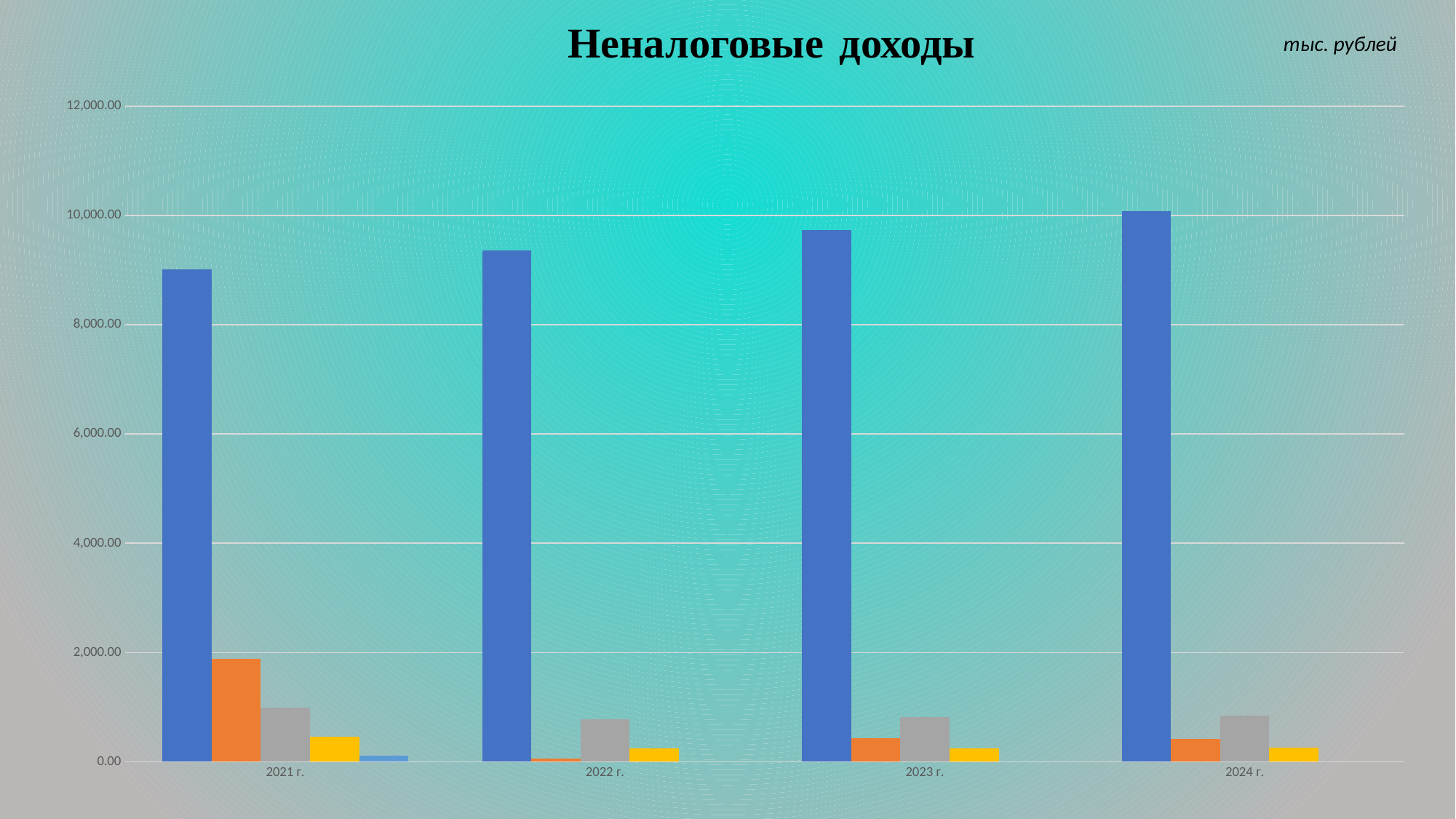
In which year is the dark blue bar the highest? 2024 г. What unit is indicated in the top right corner of the chart? тыс. рублей In which year is the dark blue bar the lowest? 2021 г. What is the title of the chart? Неналоговые доходы Is the value of the orange bar for 2021 г. greater or less than 2,000.00? less How many year categories are shown on the x axis? 4 What kind of chart is shown on the slide? bar chart Is the value of the dark blue bar for 2021 г. greater or less than 8,000.00? greater Which is larger for 2023 г.: the gray bar or the yellow bar? the gray bar Which is larger: the orange bar for 2021 г. or the orange bar for 2022 г.? 2021 г. Do the values of the tallest (dark blue) bars rise or fall from 2021 г. to 2024 г.? rise Is the value of the dark blue bar for 2023 г. greater or less than 10,000.00? less